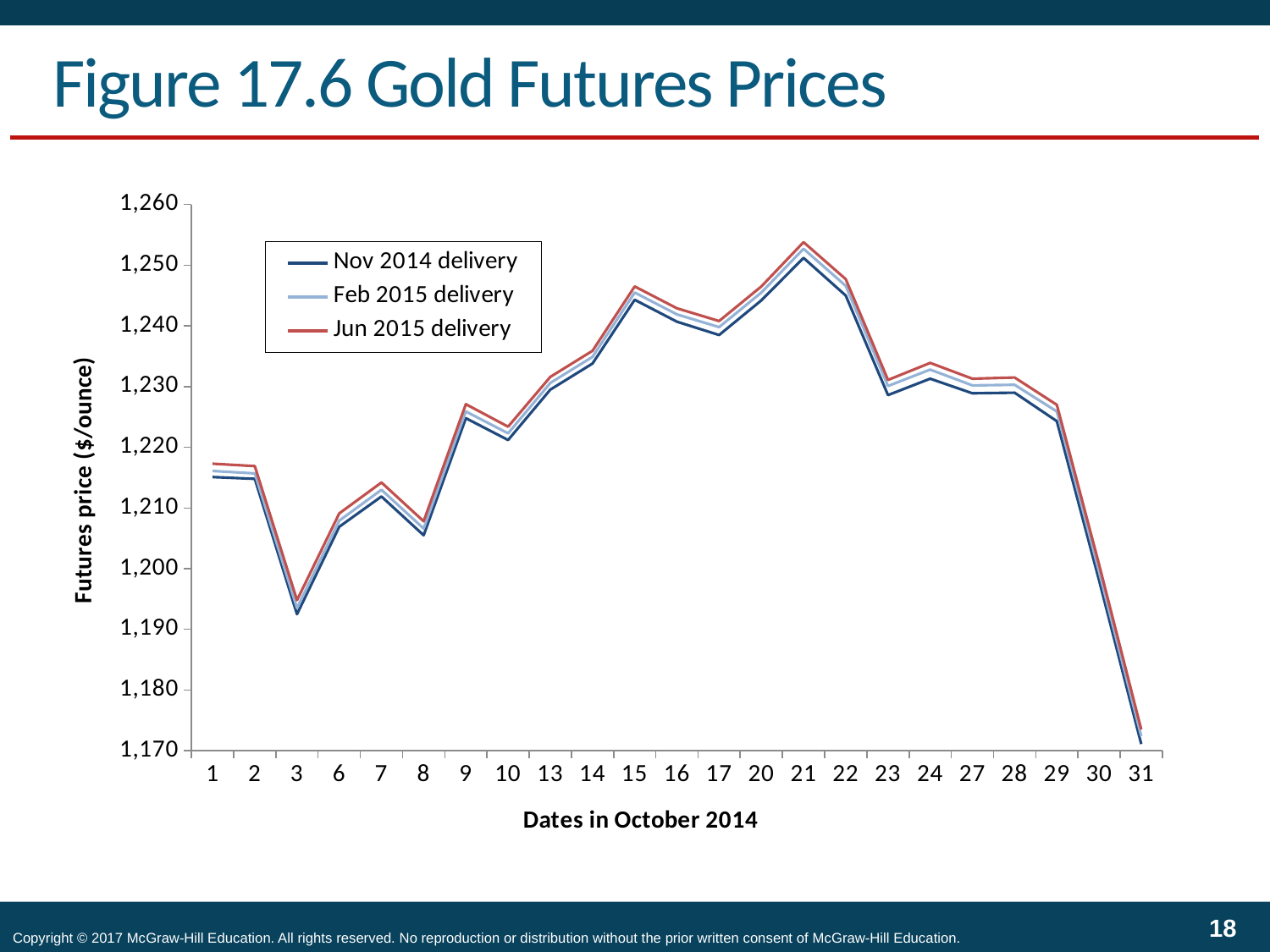
On which date in October 2014 do the gold futures prices reach their highest point? 21 On which date in October 2014 do the gold futures prices reach their lowest point? 31 Is the Jun 2015 delivery price on October 15 greater or less than 1,240? greater Is the Jun 2015 delivery price on October 21 greater or less than 1,250? greater How many dates are shown along the x axis? 23 On October 21, which is higher: the Jun 2015 delivery price or the Nov 2014 delivery price? Jun 2015 delivery What kind of chart is shown on the slide? Line chart Is the Nov 2014 delivery price on October 3 greater or less than 1,200? less Do the futures prices rise or fall from October 29 to October 31? Fall How many series does the legend list? 3 What is the label on the y axis? Futures price ($/ounce)